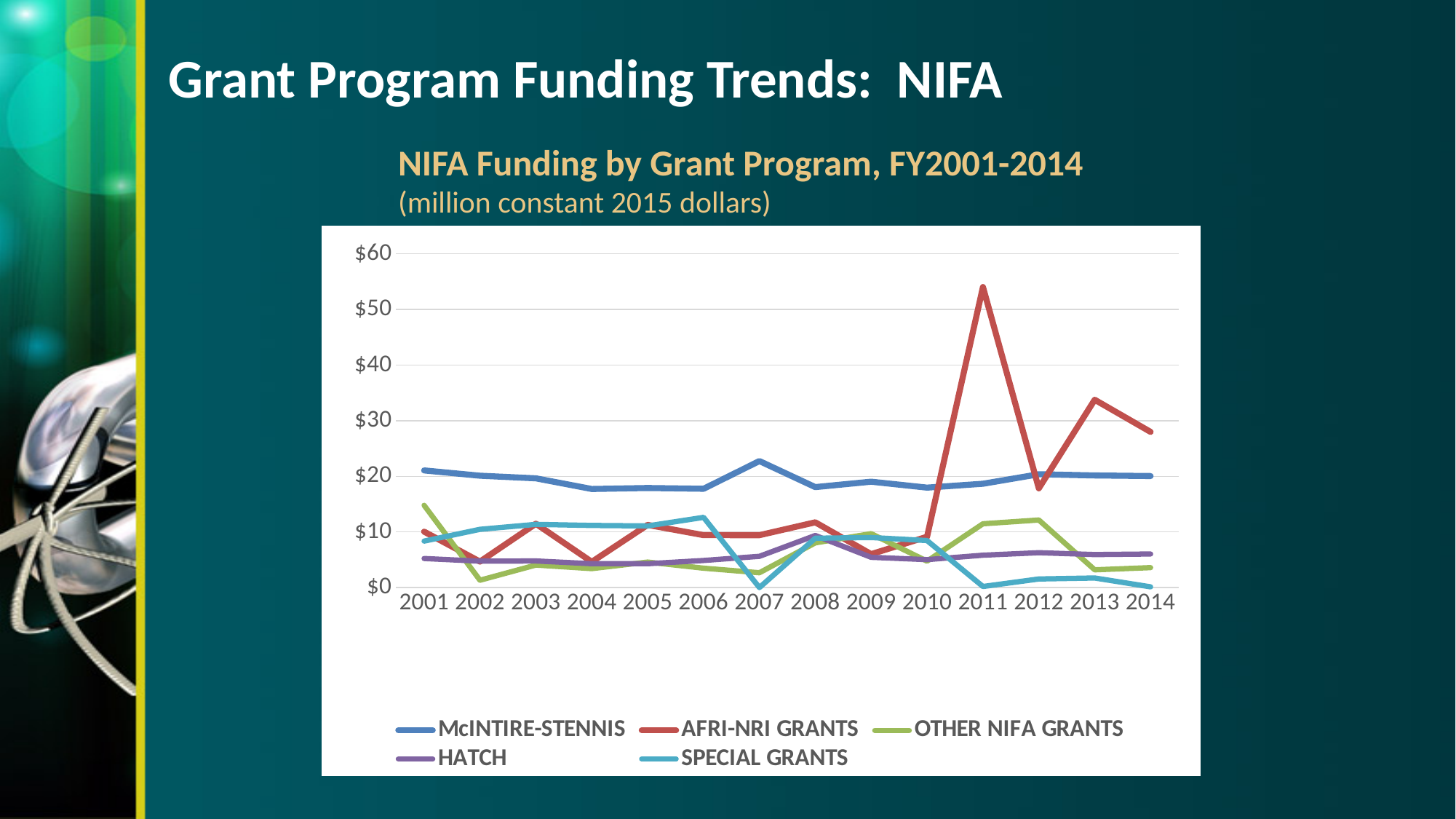
How many series does the legend list? 5 In 2011, which is larger: AFRI-NRI GRANTS or McINTIRE-STENNIS? AFRI-NRI GRANTS Does the AFRI-NRI GRANTS line rise or fall from 2012 to 2013? rise Which series has the lowest value in 2014? SPECIAL GRANTS What unit is stated below the chart title? million constant 2015 dollars How many years are shown along the x axis? 14 In 2001, which is larger: OTHER NIFA GRANTS or HATCH? OTHER NIFA GRANTS Which series reaches the highest value anywhere on the chart? AFRI-NRI GRANTS Is the value for SPECIAL GRANTS in 2014 greater or less than $10? less Is the value for McINTIRE-STENNIS in 2007 greater or less than $20? greater Is the value for AFRI-NRI GRANTS in 2011 greater or less than $50? greater What kind of chart is shown on the slide? line chart